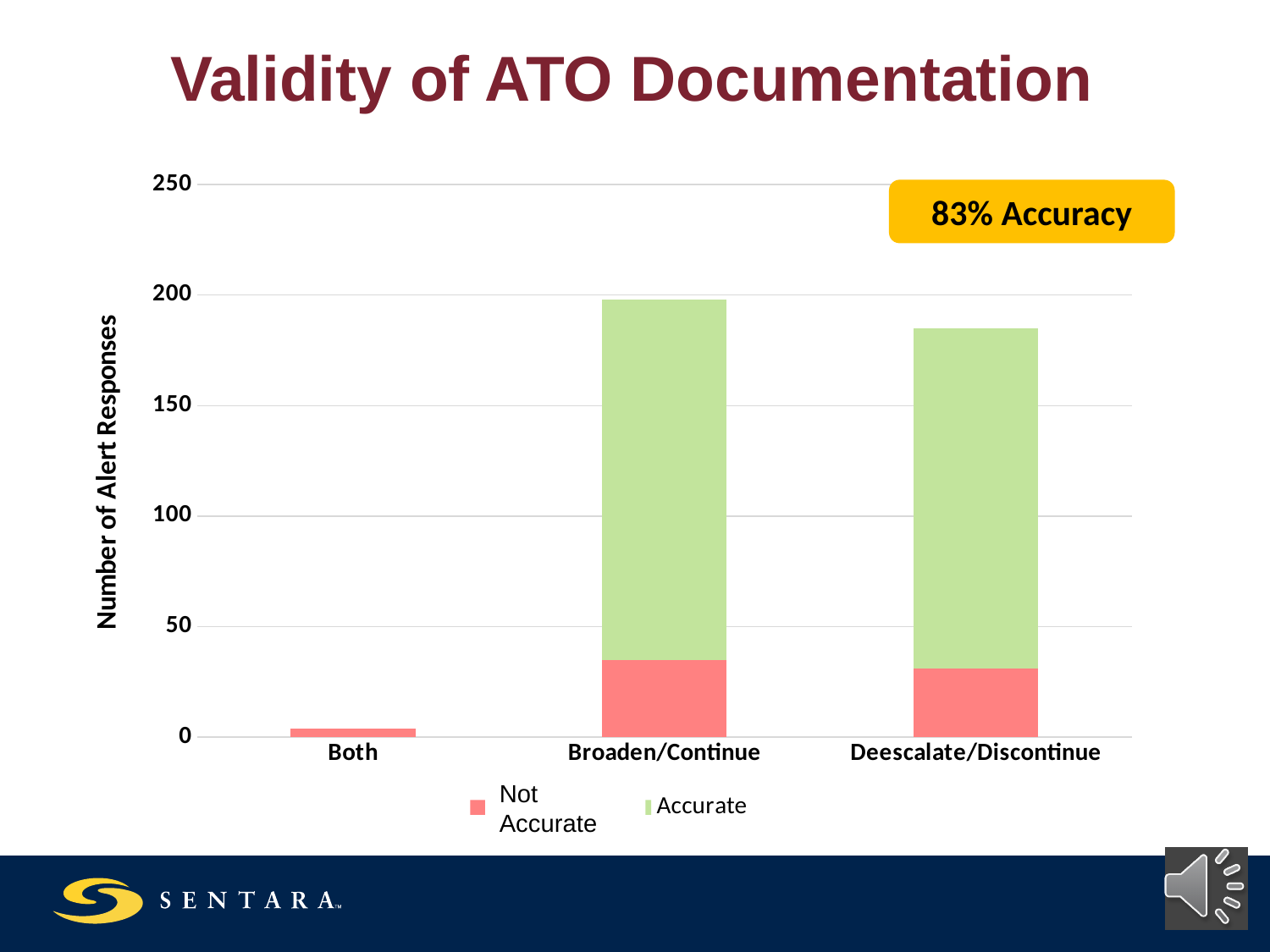
Is the total for Broaden/Continue greater or less than 150? greater How many categories are shown on the x axis of the chart? 3 Is the total for Deescalate/Discontinue greater or less than 200? less What accuracy percentage is shown in the callout box on the chart? 83% Accuracy How many series does the chart's legend list? 2 What is the title of the chart on the slide? Validity of ATO Documentation What kind of chart is shown on the slide? Stacked bar chart Is the total for Both greater or less than 50? less Which stacked bar is taller, Broaden/Continue or Deescalate/Discontinue? Broaden/Continue Which category has the tallest stacked bar? Broaden/Continue Which category has the shortest stacked bar? Both